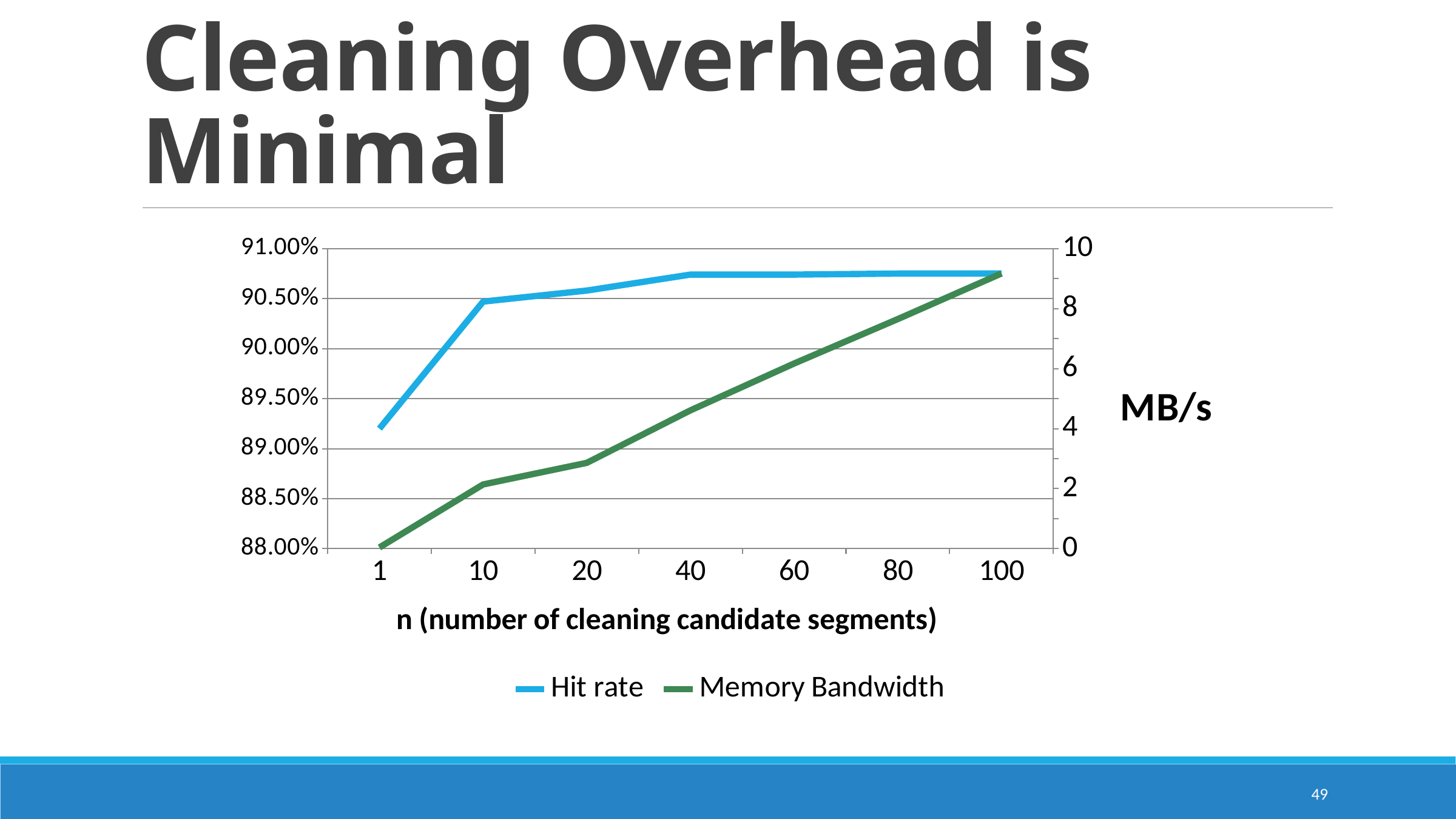
What is the title of the x axis? n (number of cleaning candidate segments) Is the Hit rate at n = 100 greater or less than 90.50%? greater Is the Hit rate at n = 10 greater or less than 90.00%? greater Does the Memory Bandwidth line rise or fall as n increases from 1 to 100? rise Is the Memory Bandwidth at n = 100 greater or less than 8 MB/s? greater Does the Hit rate line rise or fall as n increases from 1 to 10? rise How many values of n are marked along the x axis? 7 What kind of chart is shown on the slide? line chart What unit label is shown next to the right-hand axis? MB/s How many series does the legend list? 2